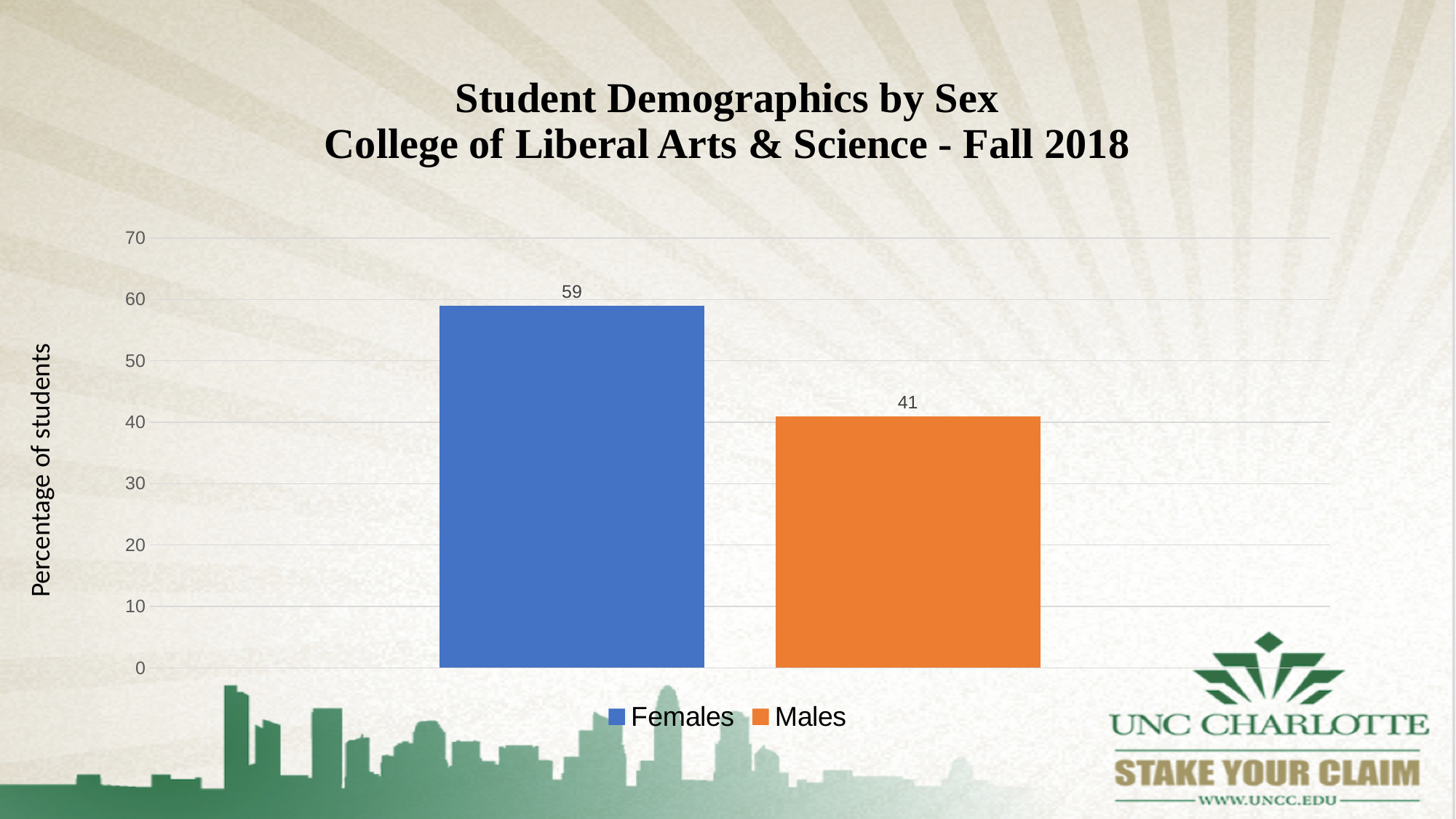
What is the value for Males? 41 How many series does the legend list? 2 Which series has the highest value? Females What kind of chart is shown on the slide? bar chart Which is larger, the value for Females or the value for Males? Females Is the value for Females greater or less than 50? greater How many bars are plotted in the chart? 2 Which series has the lowest value? Males What is the value for Females? 59 What is the difference between the Females value and the Males value? 18 What is the label on the vertical axis? Percentage of students Is the value for Males greater or less than 50? less